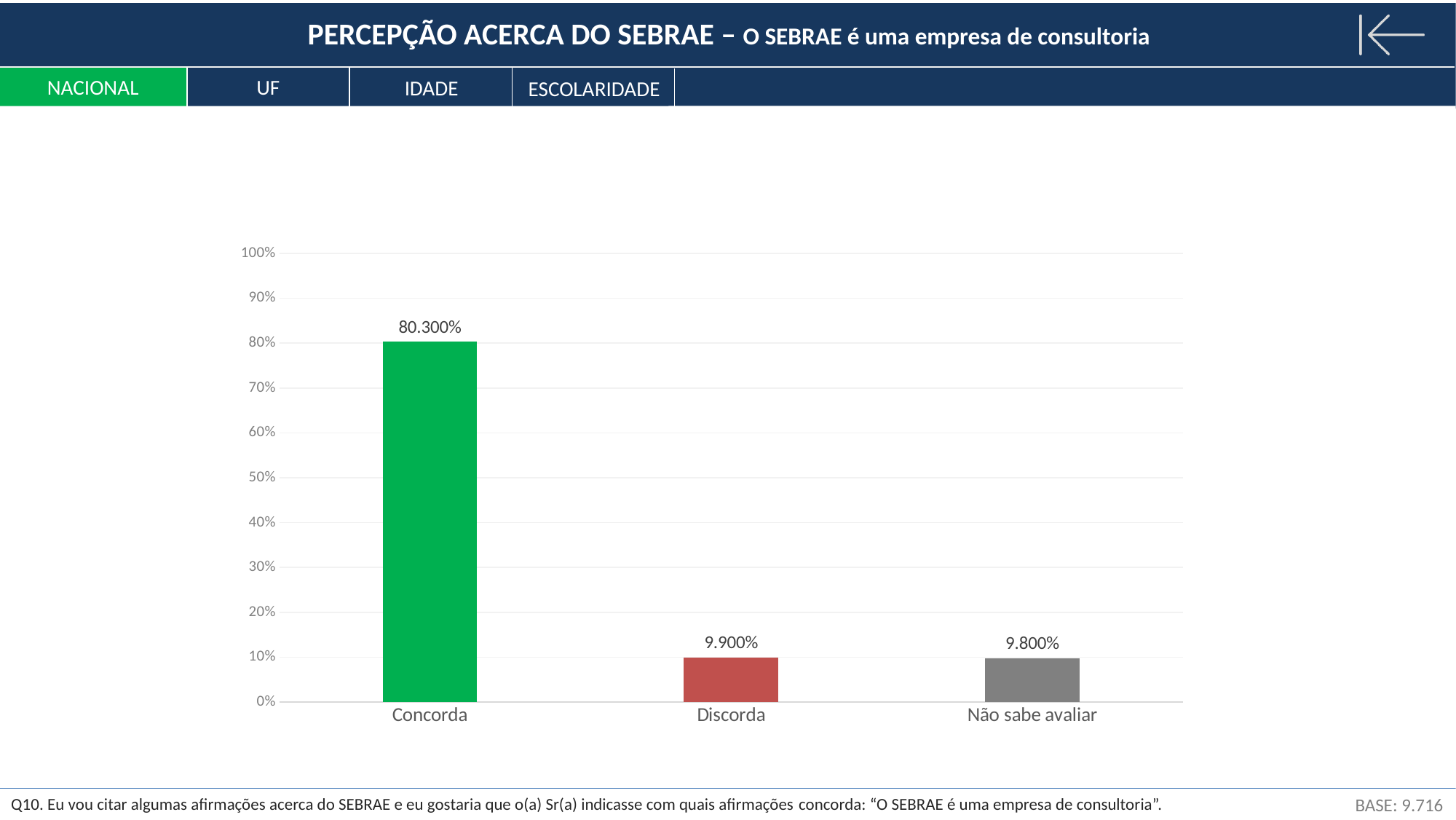
Which category has the lowest value? Não sabe avaliar How many categories are shown on the x axis? 3 What is the difference between the values for Discorda and Não sabe avaliar? 0.100% What colour is the bar for Concorda? green Which is larger, the value for Concorda or the value for Não sabe avaliar? Concorda What kind of chart is shown on the slide? bar chart What is the value for Concorda? 80.300% Is the value for Concorda greater or less than 50%? greater What is the value for Não sabe avaliar? 9.800% Which category has the highest value? Concorda What is the difference between the values for Concorda and Discorda? 70.400% What is the value for Discorda? 9.900%